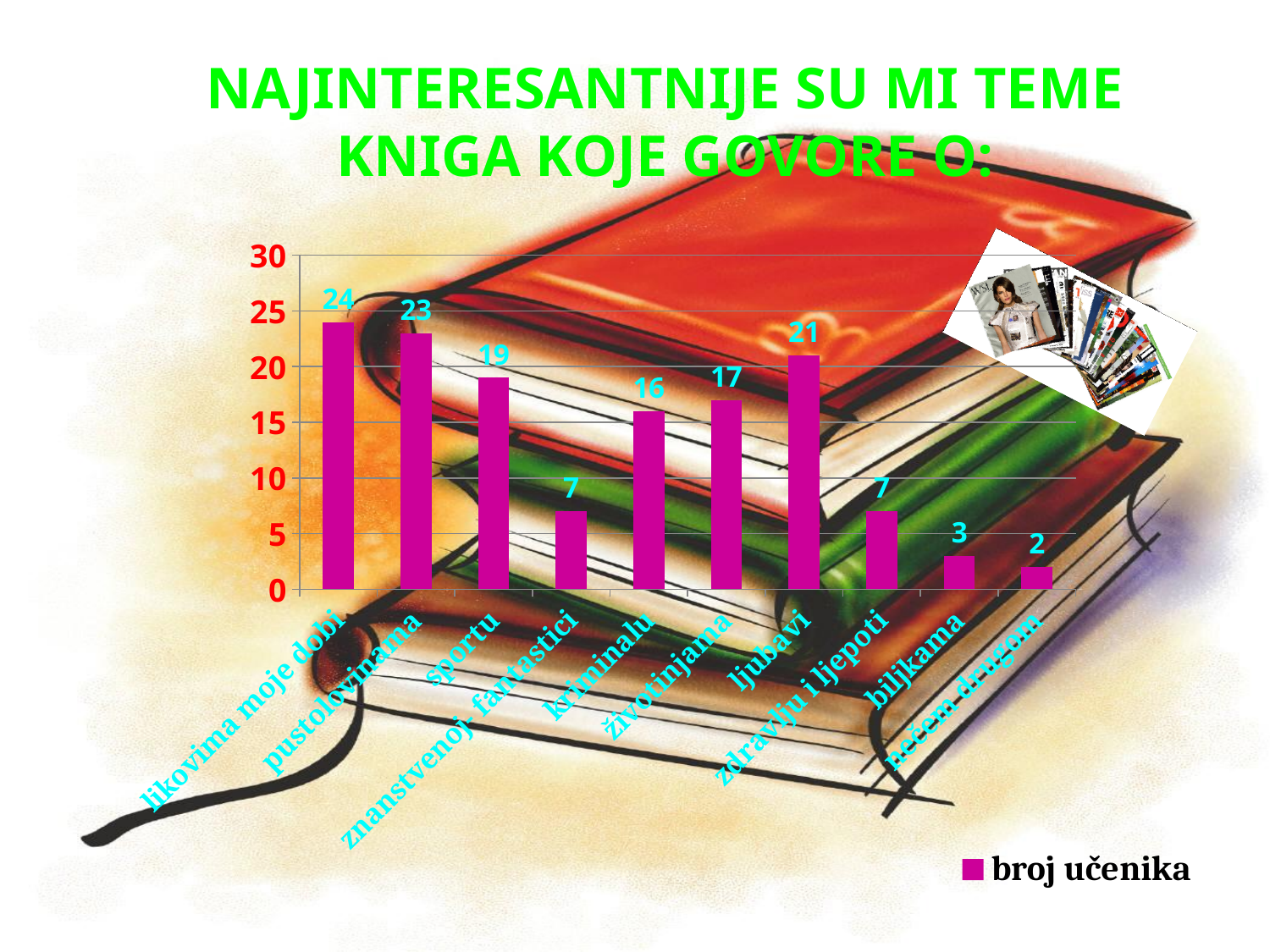
How many categories are shown on the x axis? 10 What kind of chart is shown on the slide? bar chart Which is larger, the value for 'životinjama' or the value for 'kriminalu'? životinjama How many students chose books about 'sportu'? 19 What is the value for 'ljubavi'? 21 What is the difference between the values for 'ljubavi' and 'kriminalu'? 5 What is the difference between the values for 'likovima moje dobi' and 'pustolovinama'? 1 Which category has the lowest value? nečem drugom Which category has the highest value? likovima moje dobi Is the value for 'sportu' greater or less than 15? greater What is the value for 'biljkama'? 3 What series name does the legend show? broj učenika